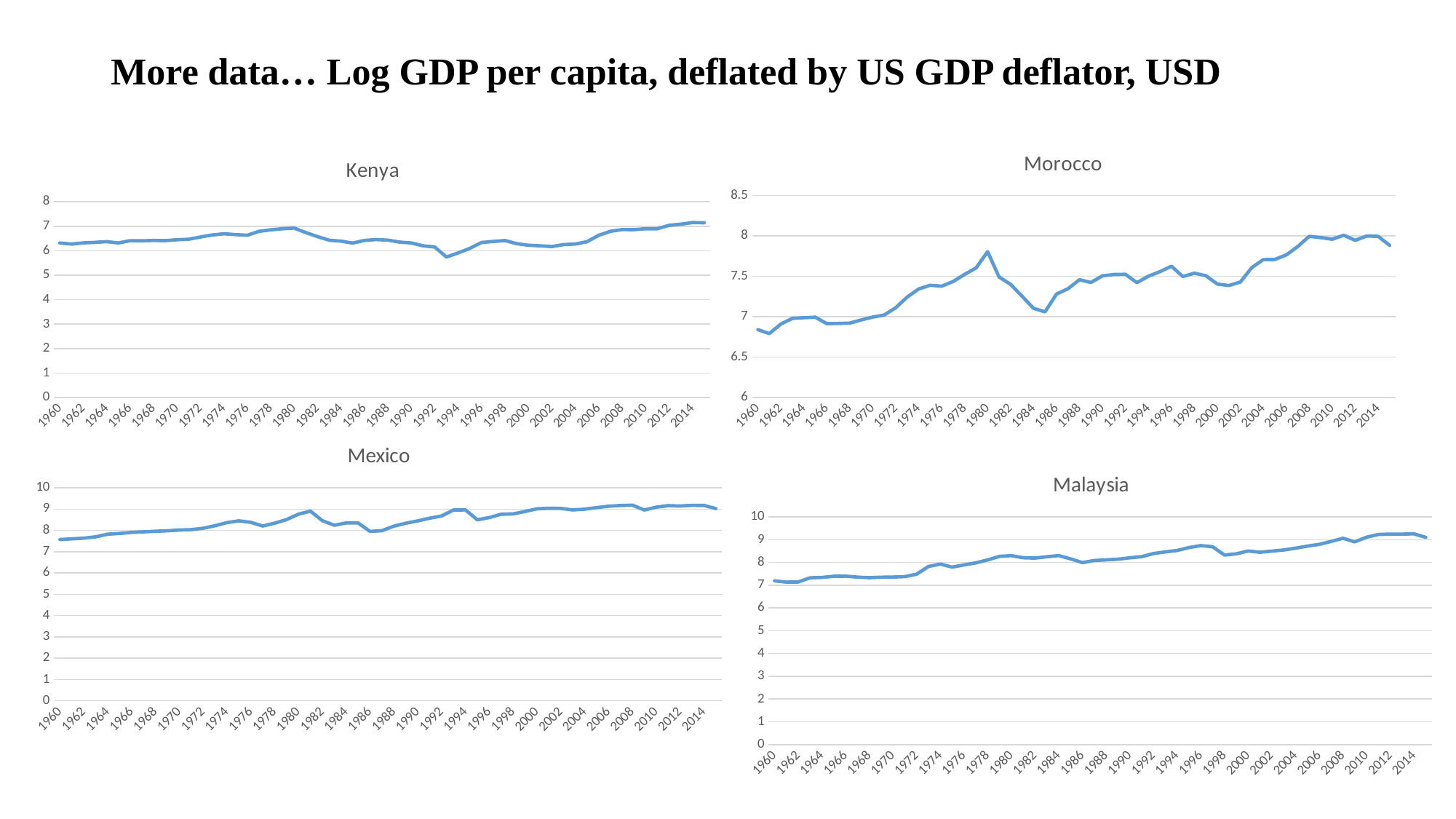
Which four countries are the charts on the slide titled after? Kenya, Morocco, Mexico, Malaysia In the Mexico chart, which year has the lowest value? 1960 What kind of chart is the Kenya chart? line chart In the Mexico chart, is the value for 2014 greater or less than 9? greater In the Morocco chart, is the value for 1980 greater or less than 7.5? greater In the Malaysia chart, is the value for 2012 greater or less than 9? greater How many charts are shown on the slide? 4 In the Kenya chart, which year has the lowest value? 1993 In the Malaysia chart, do the values generally rise or fall from 1960 to 2014? rise